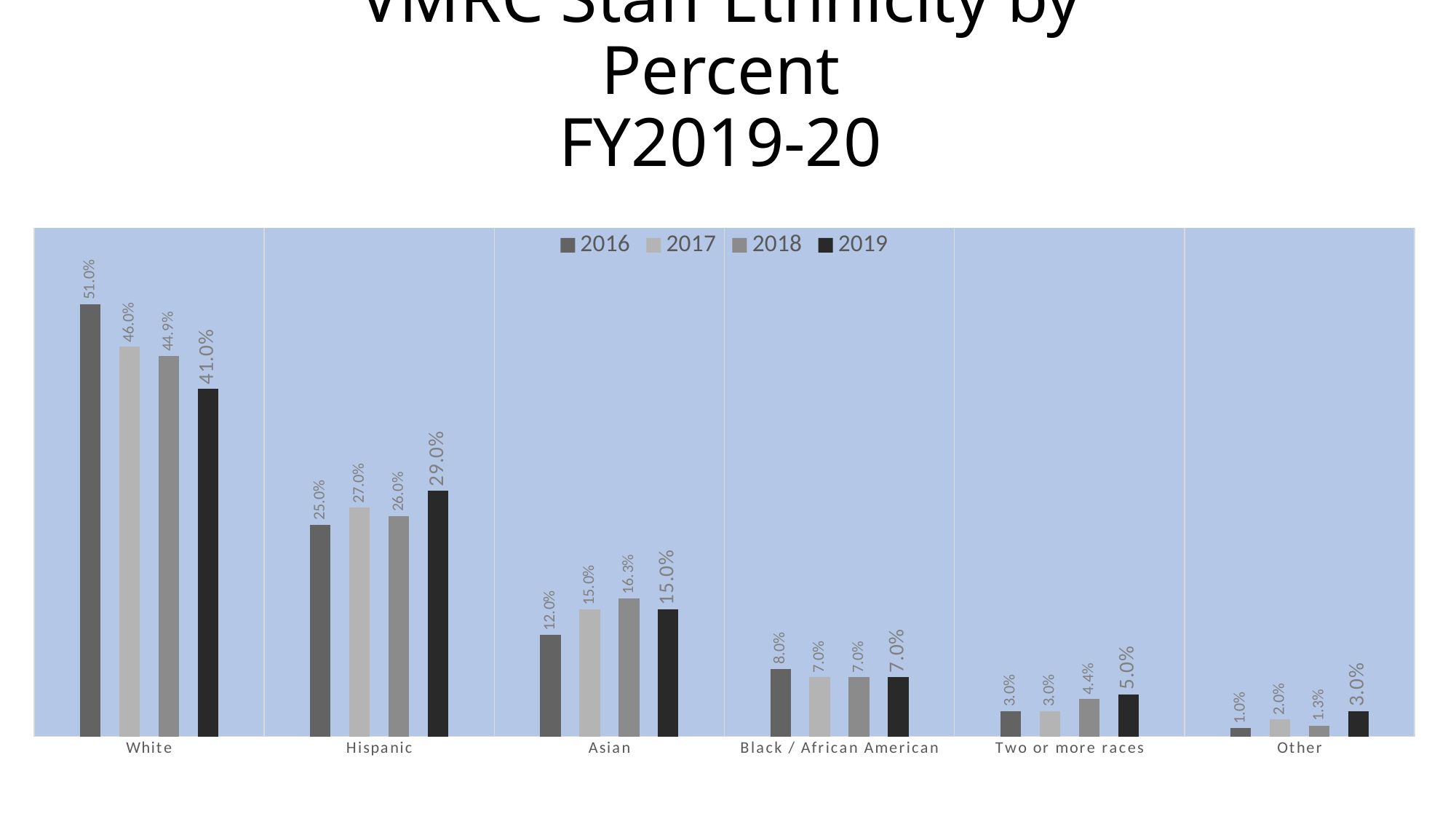
What is the 2018 value for Asian? 16.3% Do the values for Two or more races rise or fall from 2016 to 2019? Rise What is the 2017 value for Other? 2.0% What is the difference between the 2016 and 2019 values for White? 10.0% Which category has the lowest 2016 value? Other Which category has the highest 2019 value? White What is the 2019 value for White? 41.0% How many ethnicity categories are shown on the x axis? 6 What is the 2016 value for Hispanic? 25.0% Which is larger for Hispanic: the 2017 value or the 2019 value? 2019 How many series does the legend list? 4 What kind of chart is shown? Bar chart